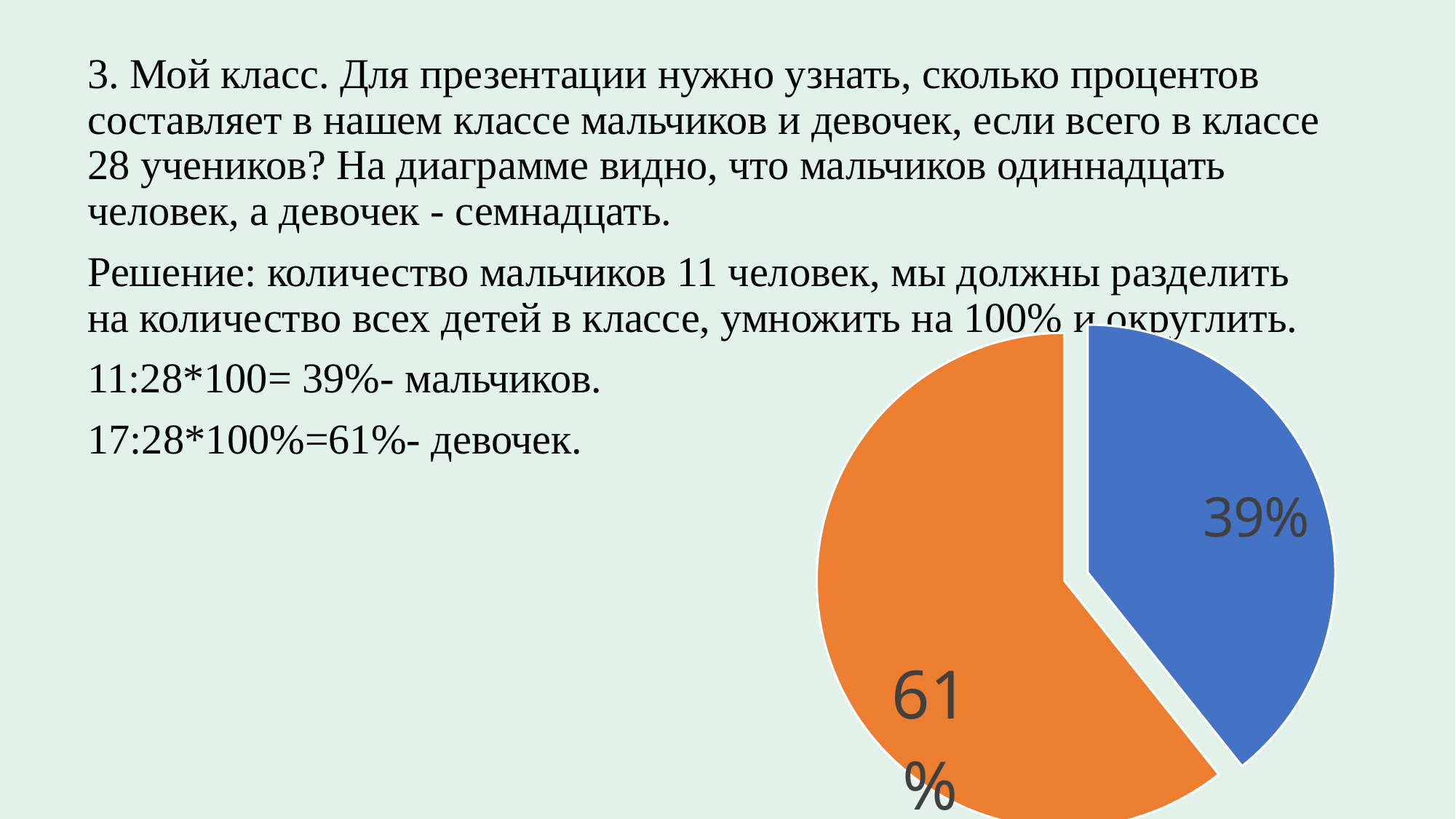
What percentage is shown on the orange slice of the pie chart? 61% Which is larger in the pie chart, the blue slice or the orange slice? The orange slice What percentage is shown on the blue slice of the pie chart? 39% Which slice of the pie chart is the largest? The orange slice (61%) What kind of chart is shown on the slide? Pie chart Is the share of the blue slice greater or less than 50%? less What two colours are used for the slices of the pie chart? Blue and orange By how many percentage points does the orange slice exceed the blue slice? 22 percentage points How many slices does the pie chart have? 2 Which slice of the pie chart is the smallest? The blue slice (39%) What share of the pie does the orange slice represent? 61% Does the pie chart have a legend? No